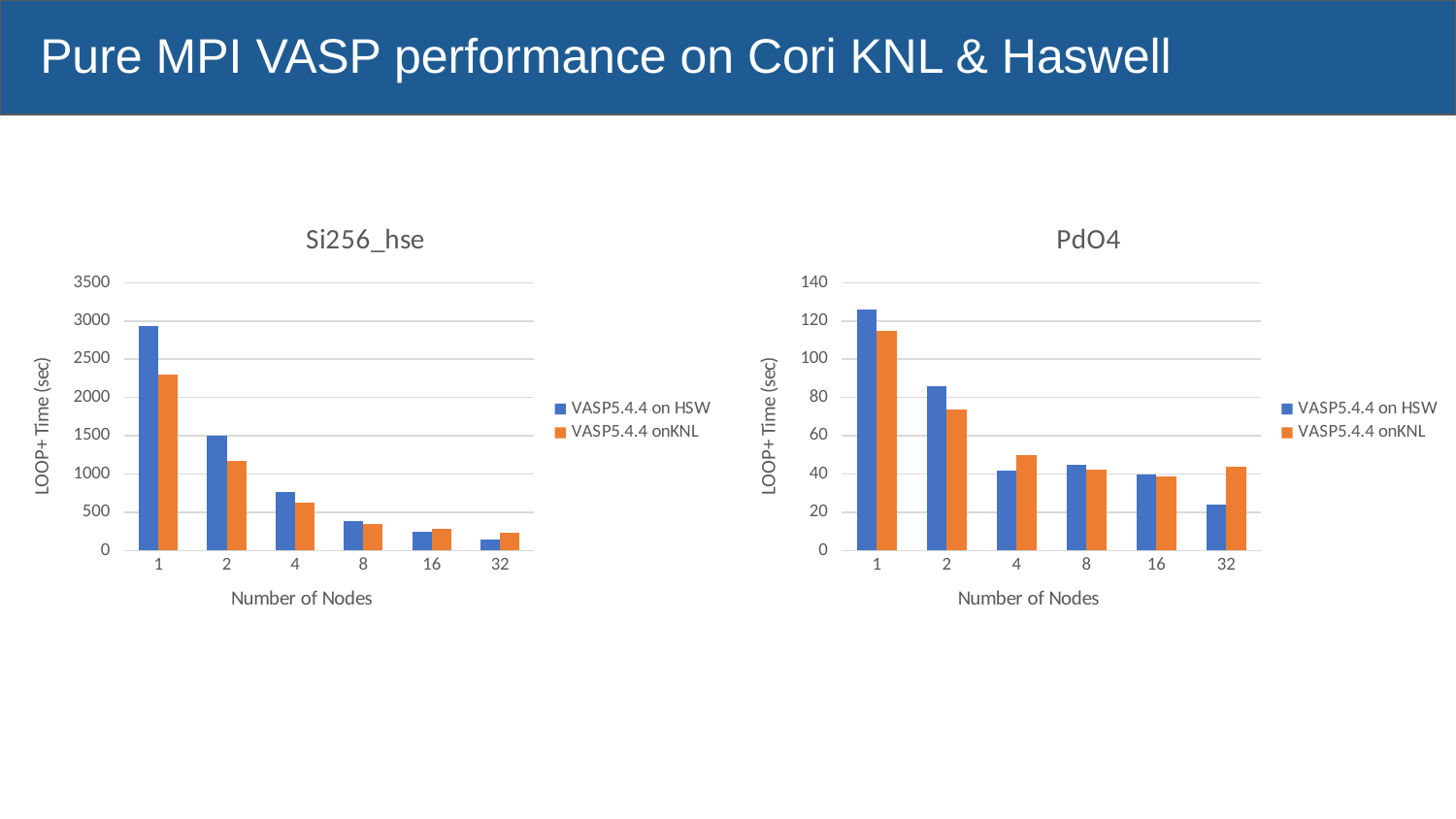
In the PdO4 chart, which is larger at 4 nodes: VASP5.4.4 on HSW or VASP5.4.4 onKNL? VASP5.4.4 onKNL How many series does the legend of the PdO4 chart list? 2 What is the y-axis label of the PdO4 chart? LOOP+ Time (sec) In the PdO4 chart, does the VASP5.4.4 on HSW time rise or fall as the number of nodes increases from 1 to 4? fall In the Si256_hse chart, which number of nodes has the highest VASP5.4.4 on HSW time? 1 In the PdO4 chart, which number of nodes has the lowest VASP5.4.4 on HSW time? 32 How many node counts are shown on the x axis of the Si256_hse chart? 6 In the PdO4 chart, is the VASP5.4.4 on HSW value at 1 node greater or less than 120? greater In the Si256_hse chart, is the VASP5.4.4 onKNL value at 2 nodes greater or less than 1500? less What type of chart is the Si256_hse chart? bar chart In the Si256_hse chart, which is larger at 32 nodes: VASP5.4.4 on HSW or VASP5.4.4 onKNL? VASP5.4.4 onKNL In the Si256_hse chart, is the VASP5.4.4 on HSW value at 1 node greater or less than 2500? greater